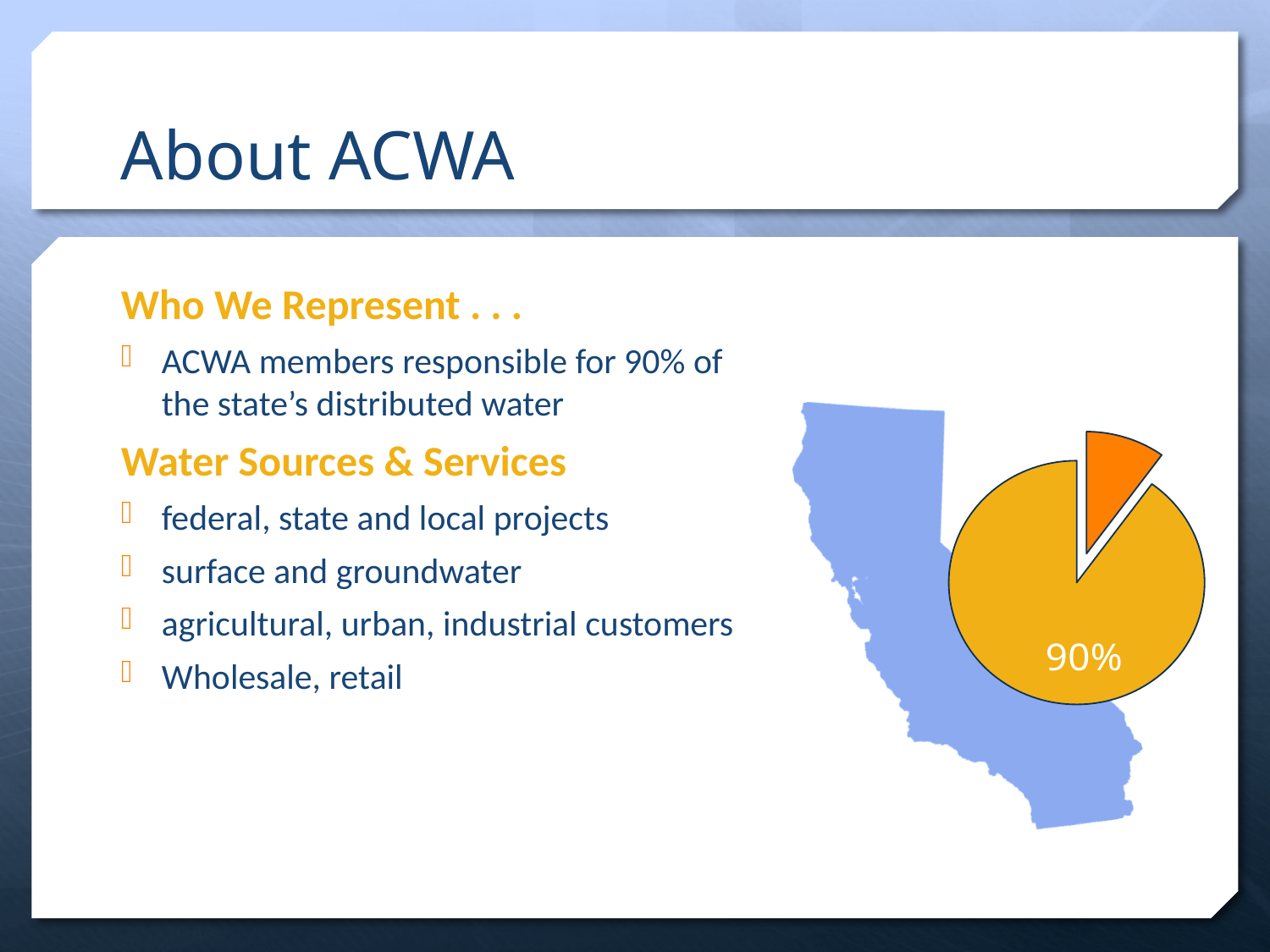
How many slices does the pie chart have? 2 What percentage is printed on the large yellow slice of the pie chart? 90% What colour is the small exploded slice of the pie chart? orange Which slice of the pie chart is larger, the yellow one or the orange one? the yellow one What kind of chart is shown on the slide? pie chart Which slice is the largest in the pie chart? the yellow slice (90%) What image is the pie chart placed over on the slide? a map of California Is the share of the yellow slice greater or less than 50%? greater Is the share of the small orange slice greater or less than 50%? less What share of the pie does the large yellow slice represent? 90%